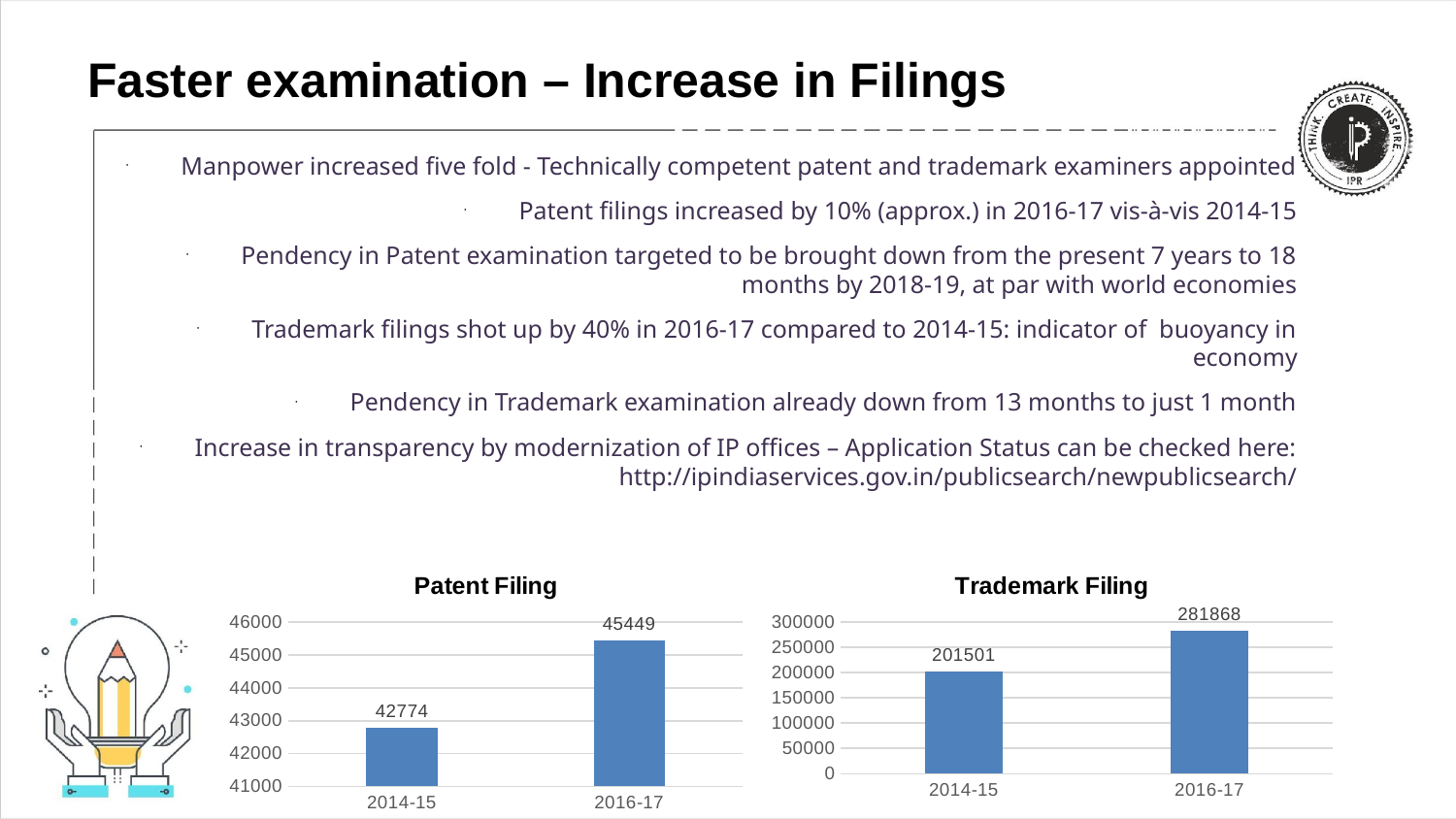
In the Patent Filing chart, what is the value for 2016-17? 45449 In the Trademark Filing chart, what is the difference between the 2016-17 and 2014-15 values? 80367 In the Patent Filing chart, which year has the higher value? 2016-17 What type of chart is the Trademark Filing chart? bar chart In the Patent Filing chart, what is the value for 2014-15? 42774 In the Trademark Filing chart, what is the value for 2016-17? 281868 In the Trademark Filing chart, is the value for 2014-15 greater or less than 250000? less In the Trademark Filing chart, what is the value for 2014-15? 201501 In the Patent Filing chart, what is the difference between the 2016-17 and 2014-15 values? 2675 How many categories are shown on the x axis of the Patent Filing chart? 2 In the Patent Filing chart, do the values rise or fall from 2014-15 to 2016-17? rise In the Trademark Filing chart, which year has the lowest value? 2014-15